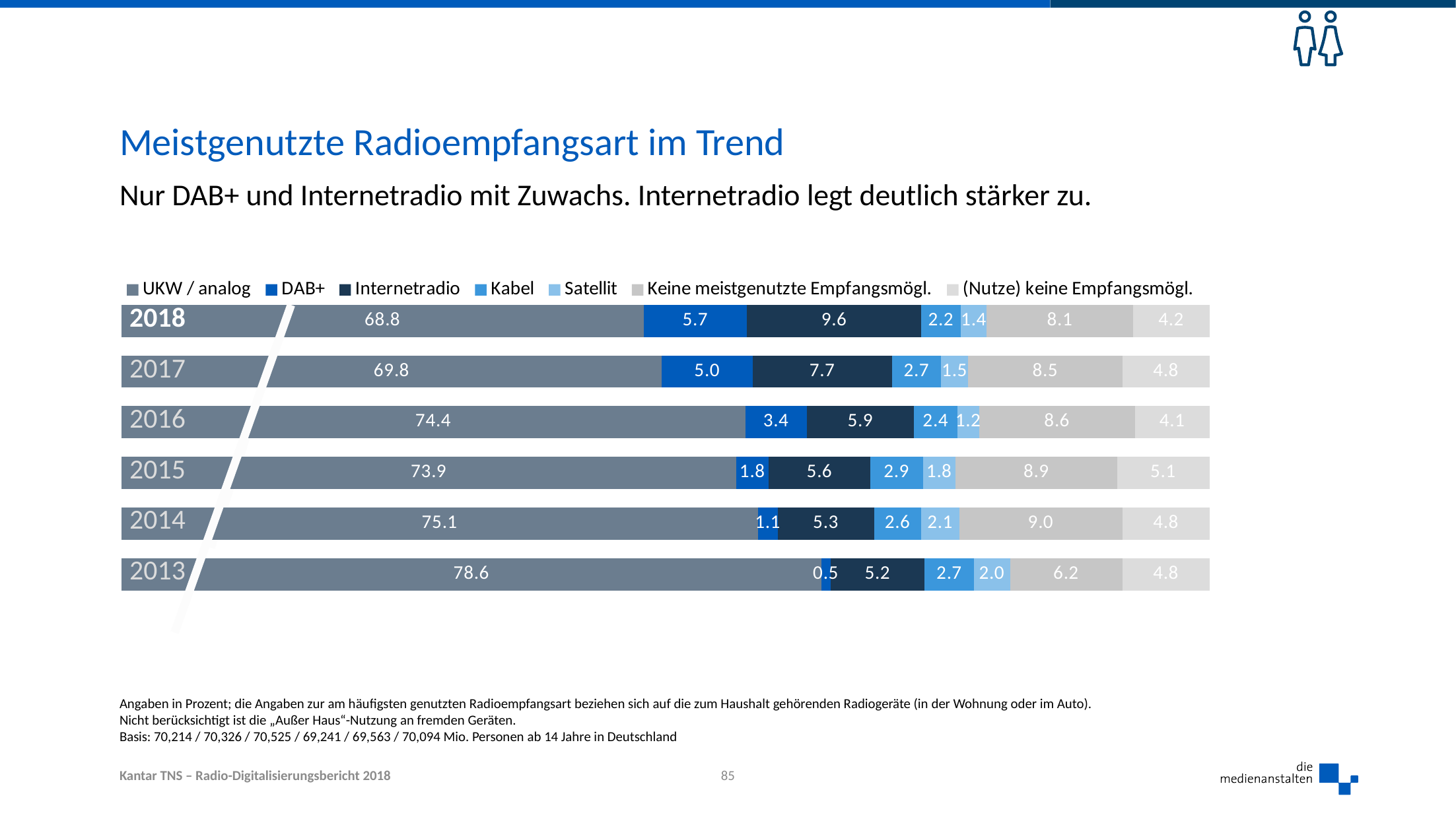
What is the value for DAB+ in 2013? 0.5 What is the value for Internetradio in 2017? 7.7 How many years are shown in the chart? 6 By how much did the Internetradio value increase from 2017 to 2018? 1.9 How many series does the legend list? 7 Which is larger, the Kabel value in 2015 or in 2018? 2015 In which year is the UKW / analog value highest? 2013 Does the UKW / analog value rise or fall from 2013 to 2018? Fall What kind of chart is shown on the slide? Stacked bar chart What is the value for Satellit in 2014? 2.1 In which year is the DAB+ value lowest? 2013 What is the value for UKW / analog in 2018? 68.8